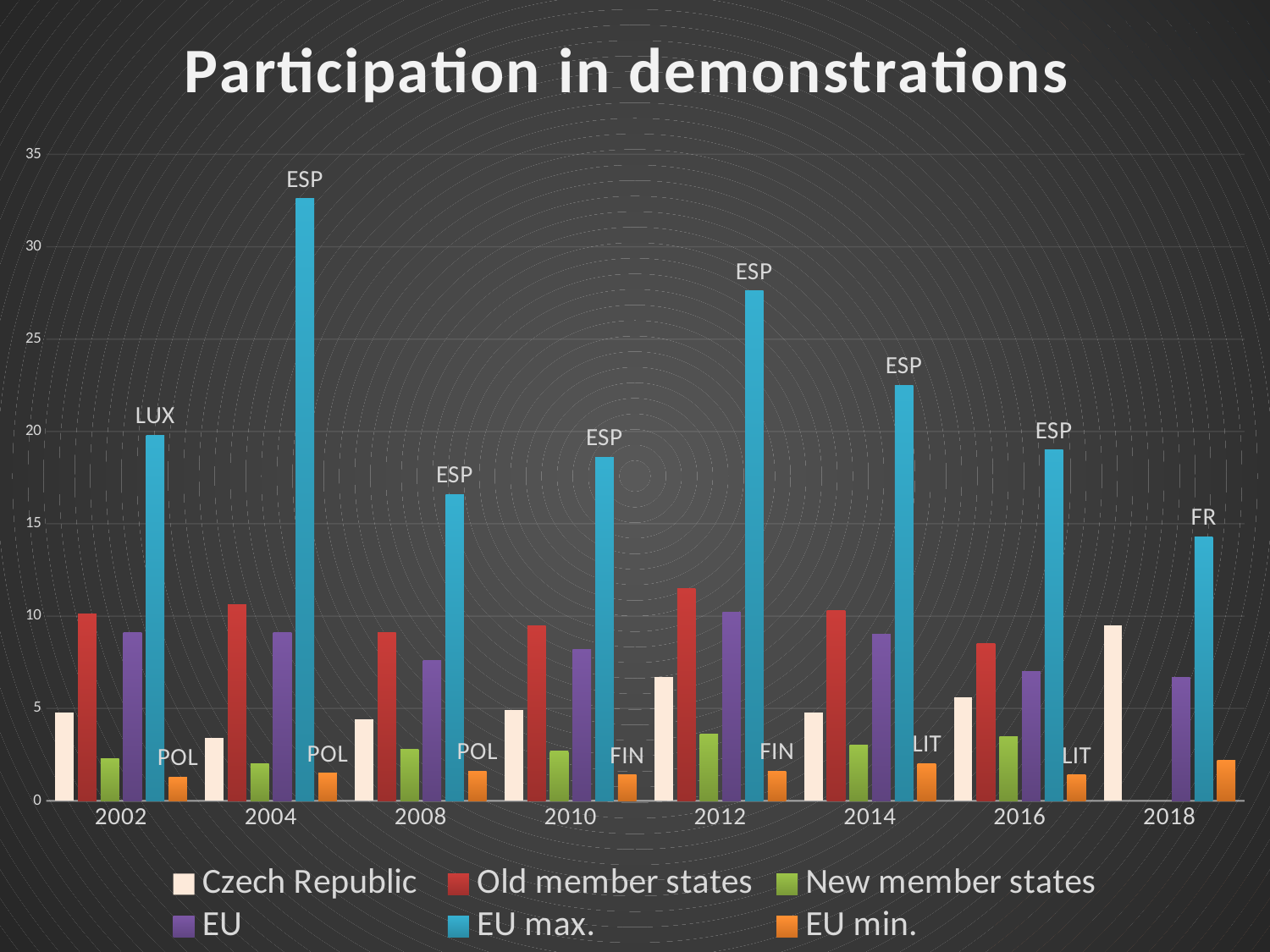
In which year is the EU max. value lowest? 2018 Is the Old member states value for 2012 greater or less than 10? greater In which year is the EU max. value highest? 2004 What is the title of the chart? Participation in demonstrations Which country label is shown above the EU max. bar for 2002? LUX Is the EU max. value for 2004 greater or less than 30? greater Is the EU max. value for 2018 greater or less than 15? less What kind of chart is shown on the slide? bar chart How many years are shown on the x axis of the chart? 8 Which year has the larger Czech Republic value, 2002 or 2018? 2018 How many series does the legend list? 6 Does the Czech Republic value rise or fall from 2014 to 2018? rise